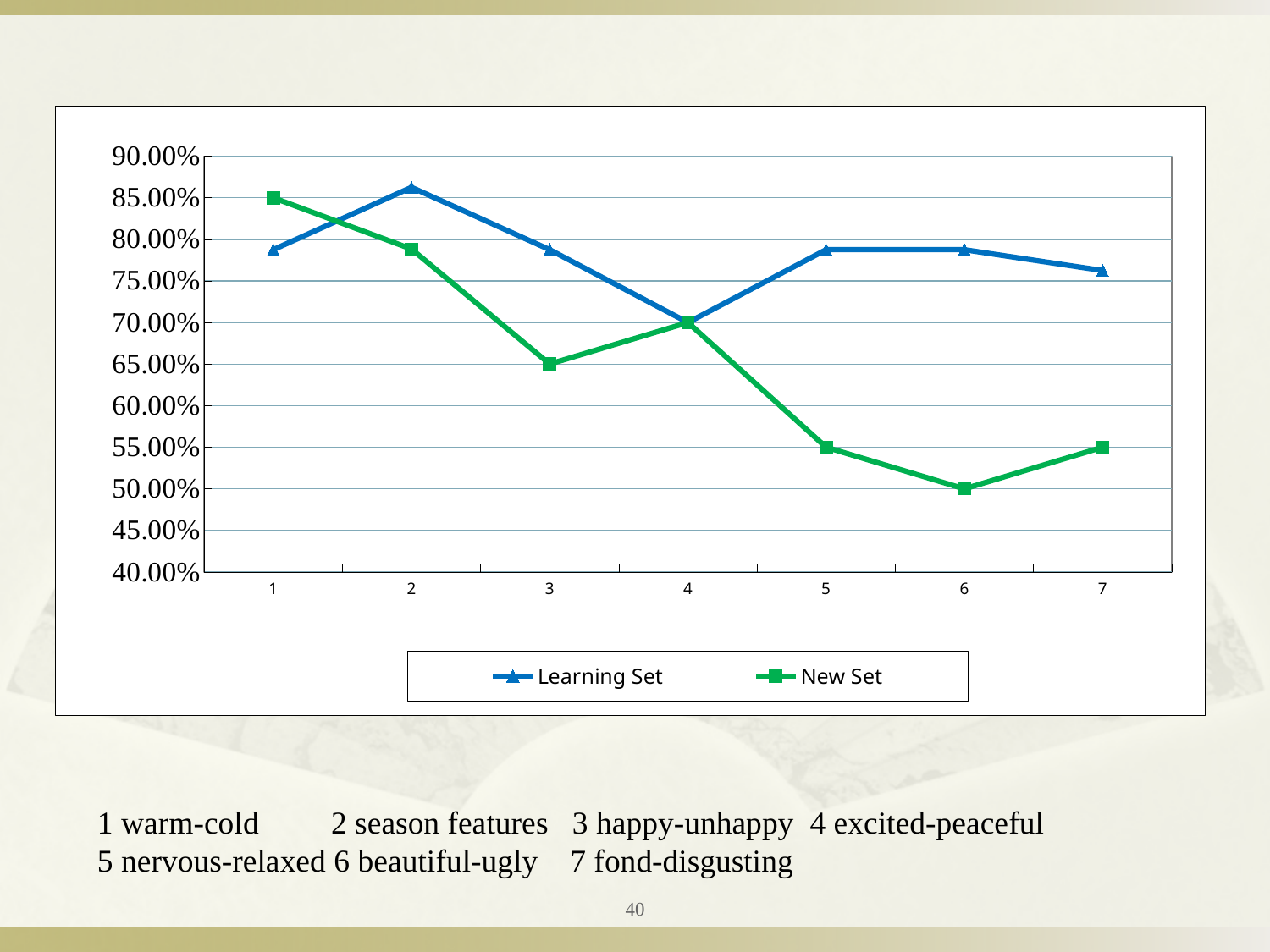
Which is larger at category 1, the Learning Set or the New Set? New Set Which series has the lowest value at category 6? New Set Which is larger at category 7, the Learning Set or the New Set? Learning Set Is the value for the Learning Set at category 2 greater or less than 85.00%? greater Does the New Set line rise or fall from category 1 to category 3? fall What colour is the New Set line? green How many points are plotted along the x axis for each series? 7 Is the value for the New Set at category 5 greater or less than 60.00%? less What kind of chart is shown on the slide? line chart At which category does the New Set reach its lowest value? 6 At which category does the Learning Set reach its highest value? 2 How many series does the legend list? 2